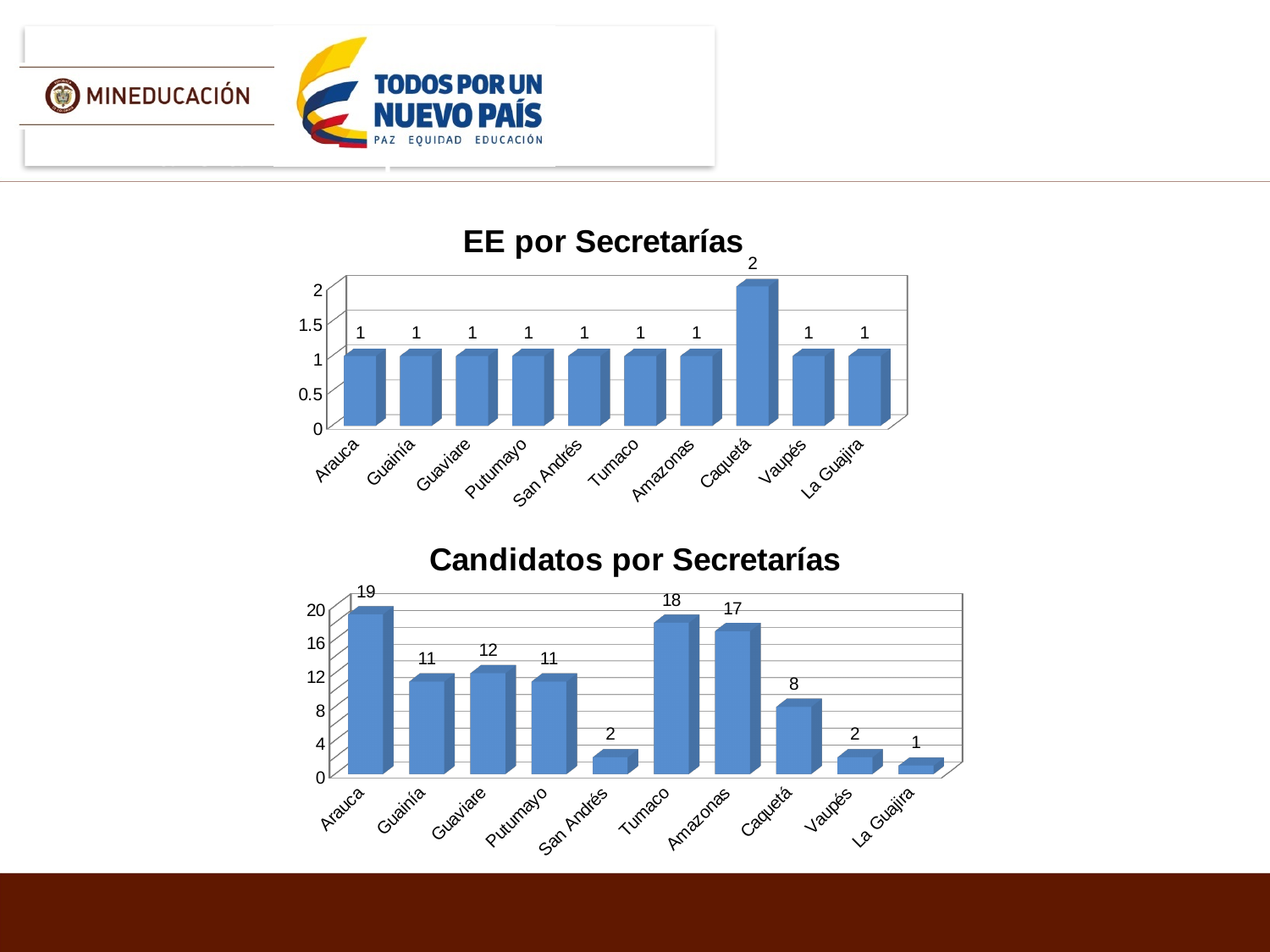
In the 'Candidatos por Secretarías' chart, what is the value for Tumaco? 18 In the 'EE por Secretarías' chart, what is the value for Caquetá? 2 In the 'EE por Secretarías' chart, which category has the highest value? Caquetá In the 'Candidatos por Secretarías' chart, what is the value for Arauca? 19 In the 'Candidatos por Secretarías' chart, which category has the highest value? Arauca In the 'Candidatos por Secretarías' chart, is the value for Putumayo greater or less than 8? greater In the 'Candidatos por Secretarías' chart, which is larger, the value for Guaviare or the value for Amazonas? Amazonas In the 'EE por Secretarías' chart, how many categories are shown on the x axis? 10 In the 'Candidatos por Secretarías' chart, which category has the lowest value? La Guajira What kind of chart is 'EE por Secretarías'? bar chart In the 'Candidatos por Secretarías' chart, what is the difference between the values for Arauca and Caquetá? 11 What is the title of the lower chart on the slide? Candidatos por Secretarías